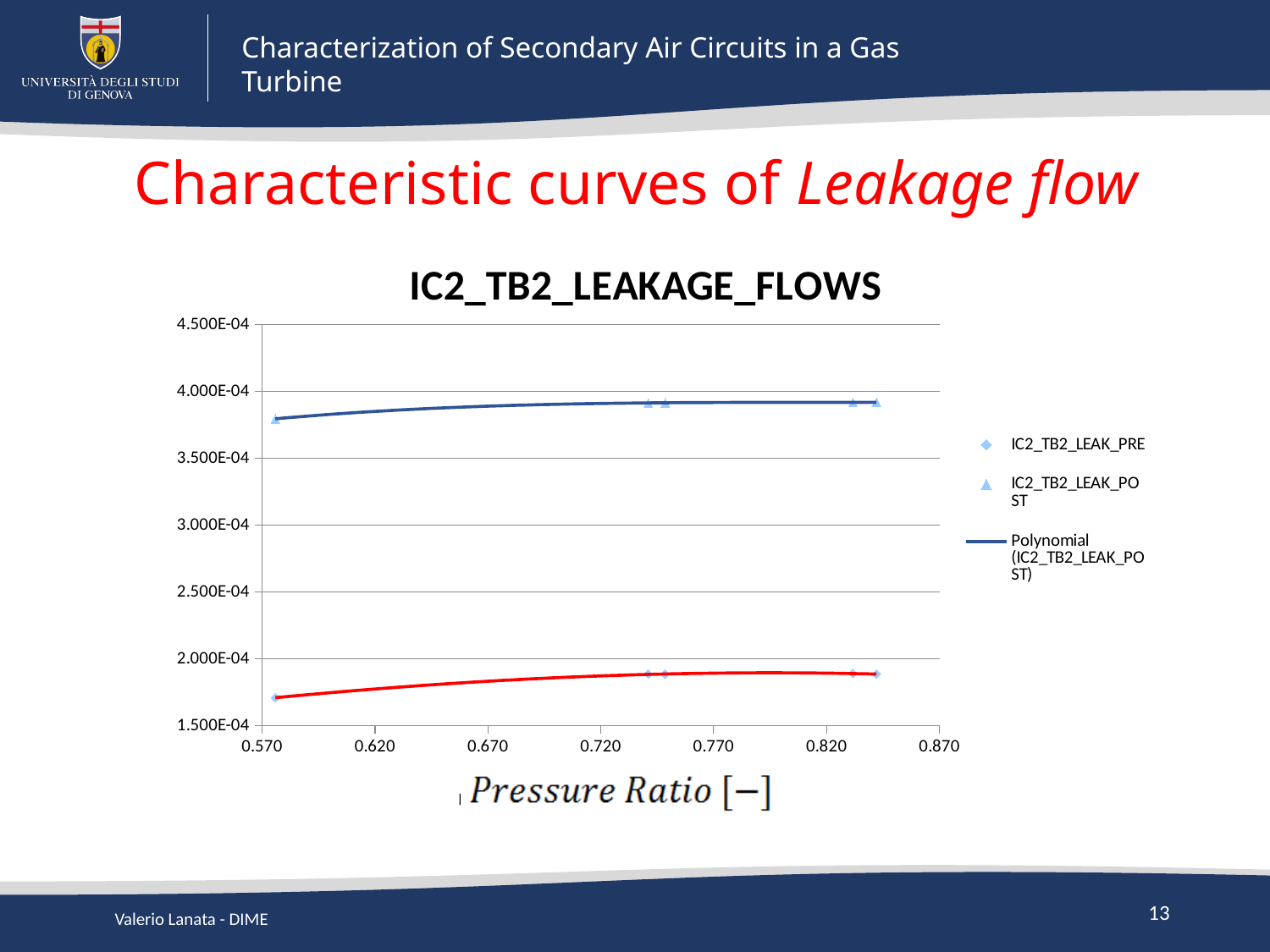
What is the lowest value shown on the y axis? 1.500E-04 Which series does the Polynomial trendline in the legend refer to? IC2_TB2_LEAK_POST What is the title of the chart? IC2_TB2_LEAKAGE_FLOWS Are the values of the IC2_TB2_LEAK_POST series greater or less than 4.000E-04? less How many entries does the chart legend list? 3 Are the values of the IC2_TB2_LEAK_PRE series greater or less than 2.000E-04? less Are the values of the IC2_TB2_LEAK_POST series greater or less than 3.500E-04? greater Which series has the higher values, IC2_TB2_LEAK_PRE or IC2_TB2_LEAK_POST? IC2_TB2_LEAK_POST Do the IC2_TB2_LEAK_POST values rise or fall as the pressure ratio increases from 0.570 to about 0.740? rise What kind of chart is shown on the slide? scatter chart with fitted curves